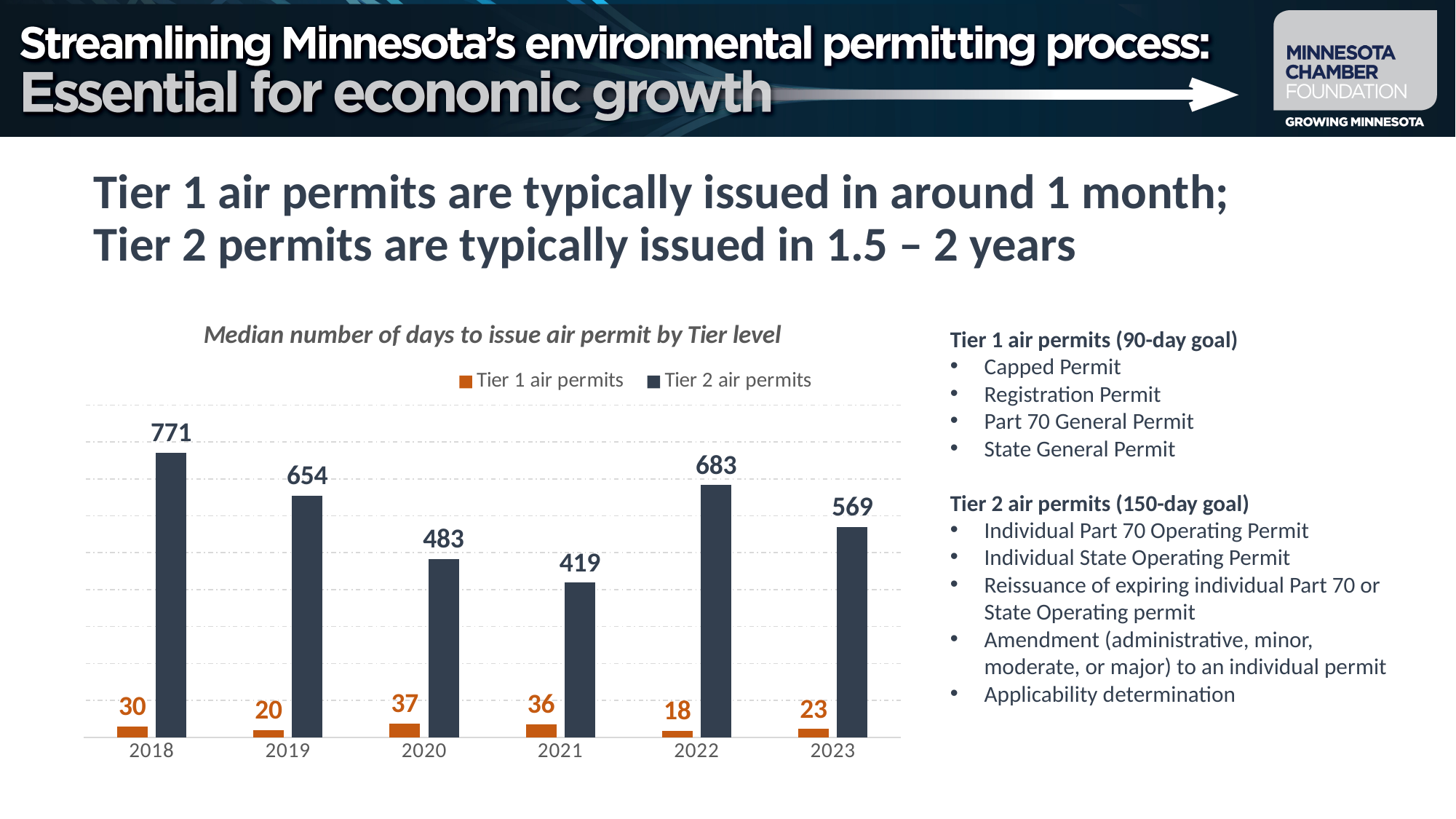
What is the value for Tier 2 air permits in 2023? 569 Which is larger, the Tier 2 value for 2019 or for 2022? 2022 What is the median number of days to issue a Tier 1 air permit in 2020? 37 What is the difference between the Tier 1 and Tier 2 air permit values in 2022? 665 How many series does the chart's legend list? 2 Which year has the lowest value for Tier 2 air permits? 2021 Which year has the lowest value for Tier 1 air permits? 2022 What kind of chart is shown on the slide? Bar chart How many years are shown on the x axis of the chart? 6 Which year has the highest value for Tier 2 air permits? 2018 What is the difference between the Tier 2 air permit values for 2018 and 2021? 352 What is the median number of days to issue a Tier 2 air permit in 2018? 771